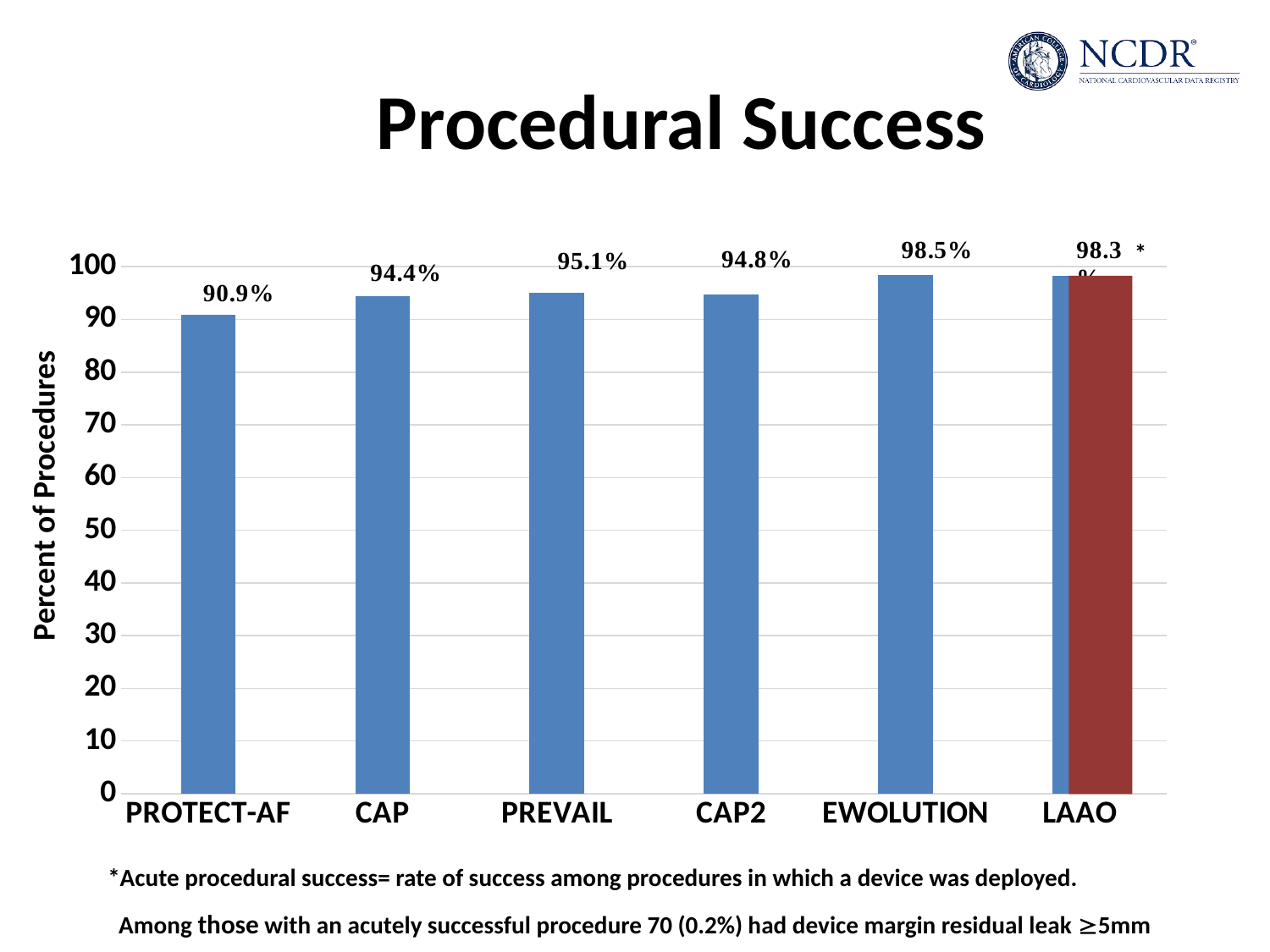
What is the procedural success value for CAP2? 94.8% What is the procedural success value for EWOLUTION? 98.5% Which is larger, the value for CAP or the value for PROTECT-AF? CAP What is the procedural success value for PROTECT-AF? 90.9% Which category has the lowest procedural success? PROTECT-AF What kind of chart is shown on the slide? bar chart What is the difference between the EWOLUTION value and the PROTECT-AF value? 7.6 percentage points How many categories are shown on the x axis? 6 Which category's bar is coloured red rather than blue? LAAO What is the title of the y axis? Percent of Procedures What is the procedural success value for LAAO? 98.3% Is the value for PROTECT-AF greater or less than 95? less